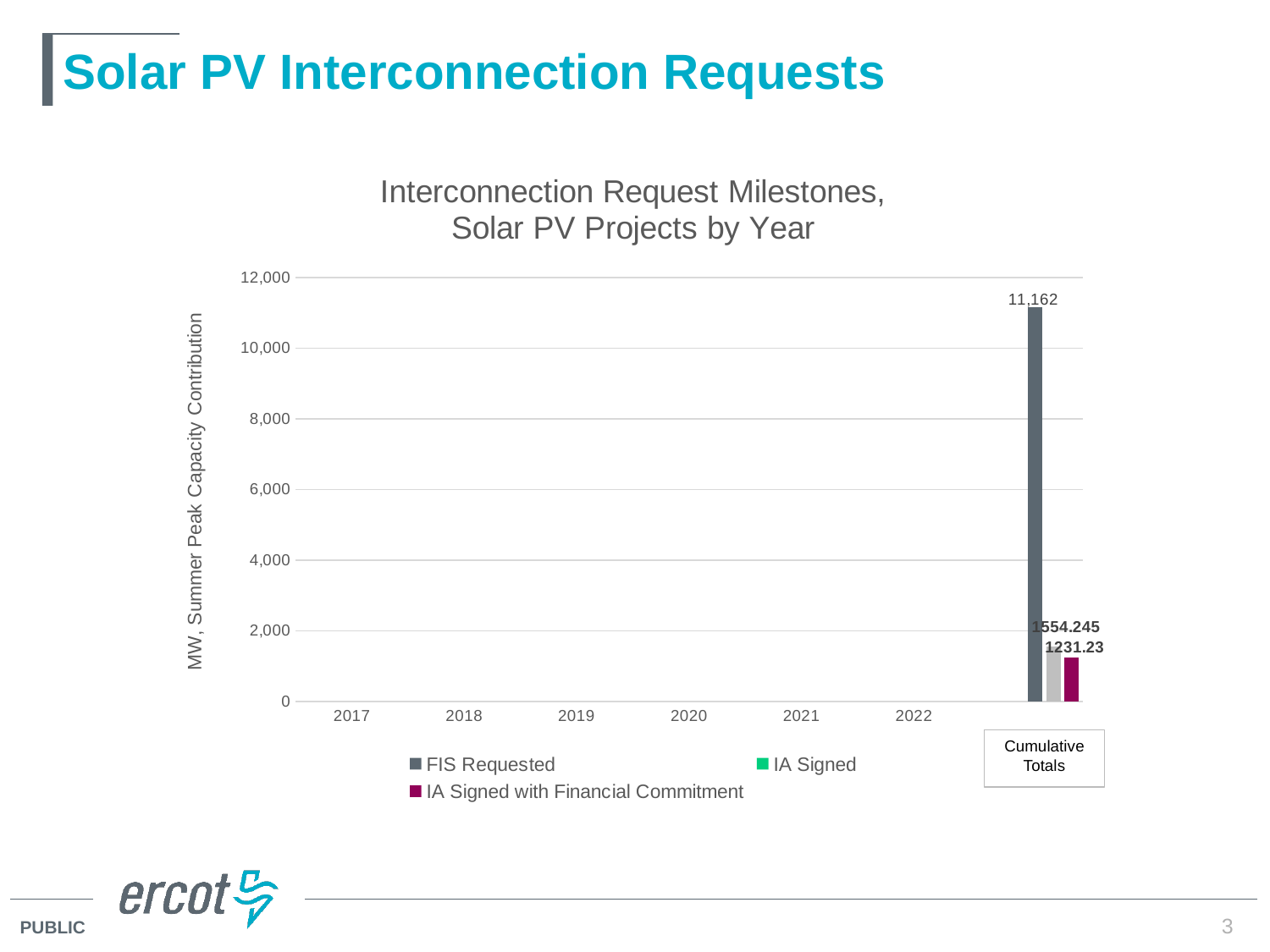
What is the title of the y axis? MW, Summer Peak Capacity Contribution What is the difference between the IA Signed value and the IA Signed with Financial Commitment value in the Cumulative Totals group? 323.015 Which series has the highest value in the Cumulative Totals group? FIS Requested What is the IA Signed value for Cumulative Totals? 1554.245 What is the FIS Requested value for Cumulative Totals? 11,162 Is the FIS Requested value for Cumulative Totals greater or less than 10,000? greater In the Cumulative Totals group, which is larger: IA Signed or IA Signed with Financial Commitment? IA Signed Which series has the lowest value in the Cumulative Totals group? IA Signed with Financial Commitment What is the IA Signed with Financial Commitment value for Cumulative Totals? 1231.23 How many years are labelled on the x axis? 6 How many series does the legend list? 3 What kind of chart is shown on the slide? bar chart